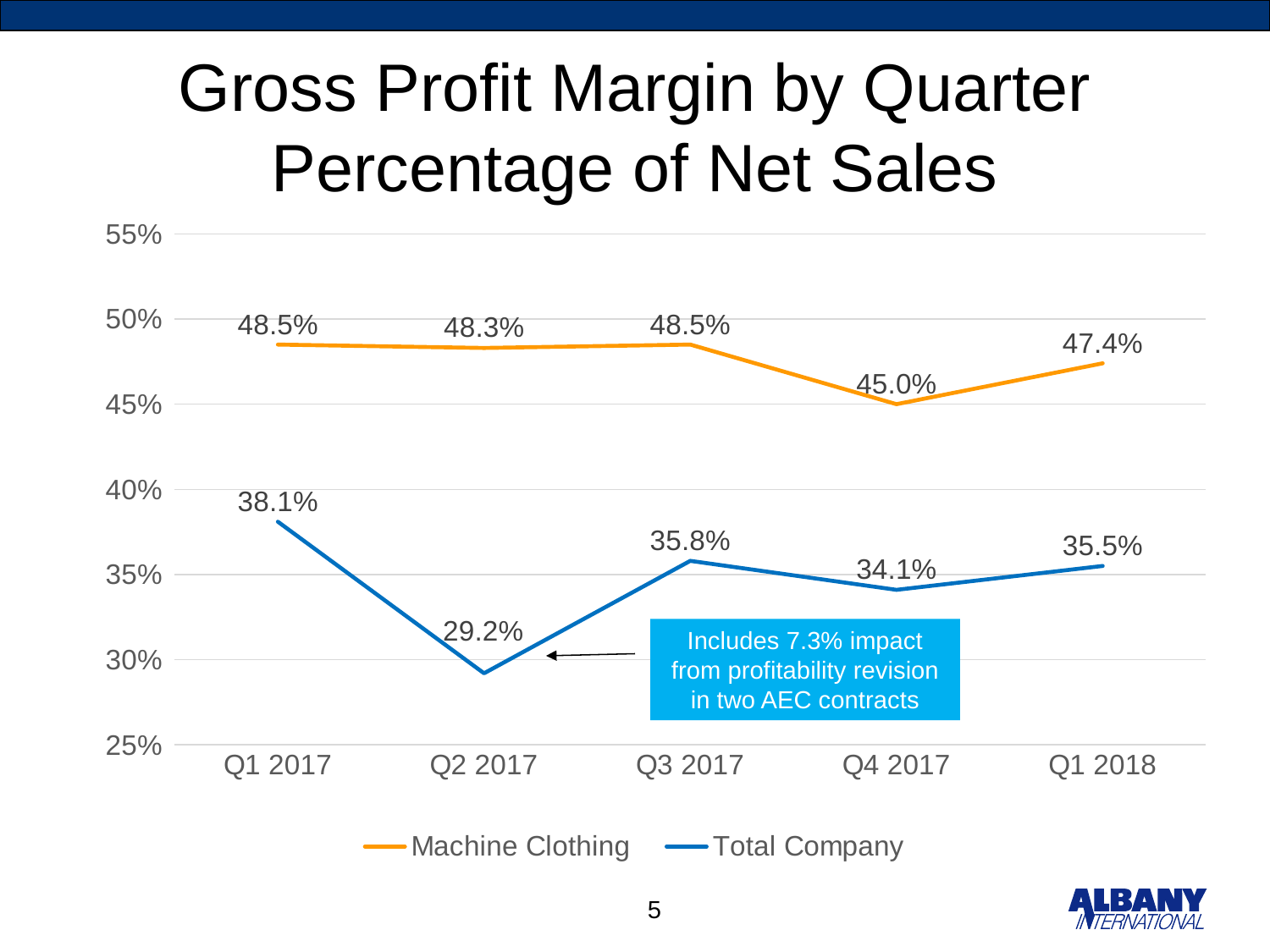
In which quarter is the Machine Clothing gross profit margin lowest? Q4 2017 Is the Total Company margin in Q2 2017 greater or less than 30%? less What is the difference between the Machine Clothing and Total Company margins in Q1 2018? 11.9% In which quarter is the Total Company gross profit margin highest? Q1 2017 How many quarters are plotted on the x axis? 5 In which quarter is the Total Company gross profit margin lowest? Q2 2017 How many series does the legend list? 2 What is the Machine Clothing gross profit margin in Q4 2017? 45.0% What kind of chart is shown on the slide? line chart Which is larger: the Total Company margin in Q3 2017 or in Q4 2017? Q3 2017 What is the Total Company gross profit margin in Q2 2017? 29.2% What is the Total Company gross profit margin in Q1 2018? 35.5%